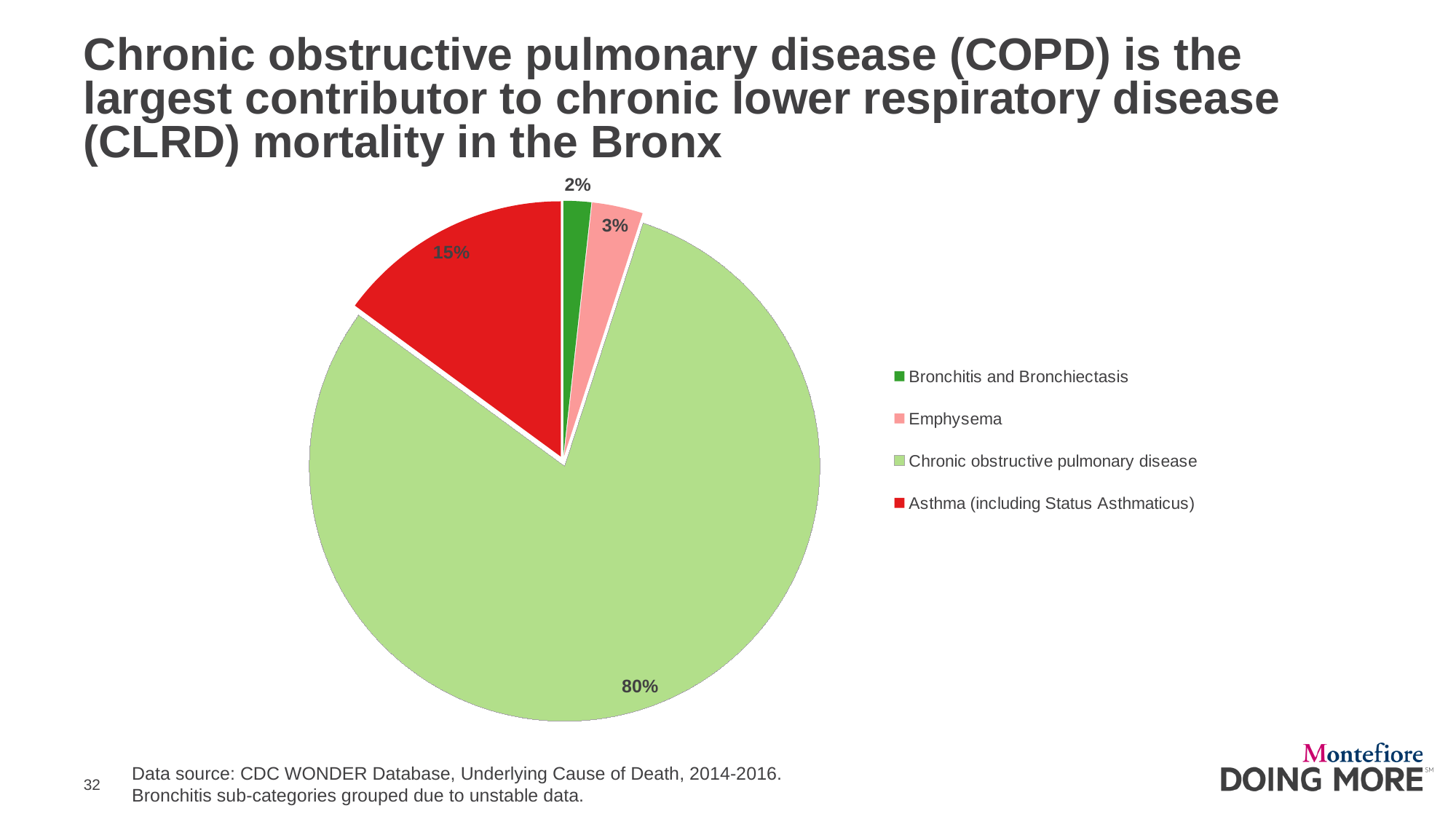
What share of CLRD mortality is attributed to Asthma (including Status Asthmaticus)? 15% What share of CLRD mortality is attributed to Bronchitis and Bronchiectasis? 2% Which is larger, the Emphysema slice or the Asthma (including Status Asthmaticus) slice? Asthma (including Status Asthmaticus) How many categories does the pie chart show? 4 What share of CLRD mortality is attributed to Emphysema? 3% What colour is the Asthma (including Status Asthmaticus) slice? red What is the difference in percentage points between the Chronic obstructive pulmonary disease slice and the Asthma (including Status Asthmaticus) slice? 65 percentage points Which category has the smallest slice of the pie? Bronchitis and Bronchiectasis Which category has the largest slice of the pie? Chronic obstructive pulmonary disease What is the combined share of the Emphysema and Bronchitis and Bronchiectasis slices? 5% What kind of chart is shown on the slide? pie chart What share of CLRD mortality is attributed to Chronic obstructive pulmonary disease? 80%